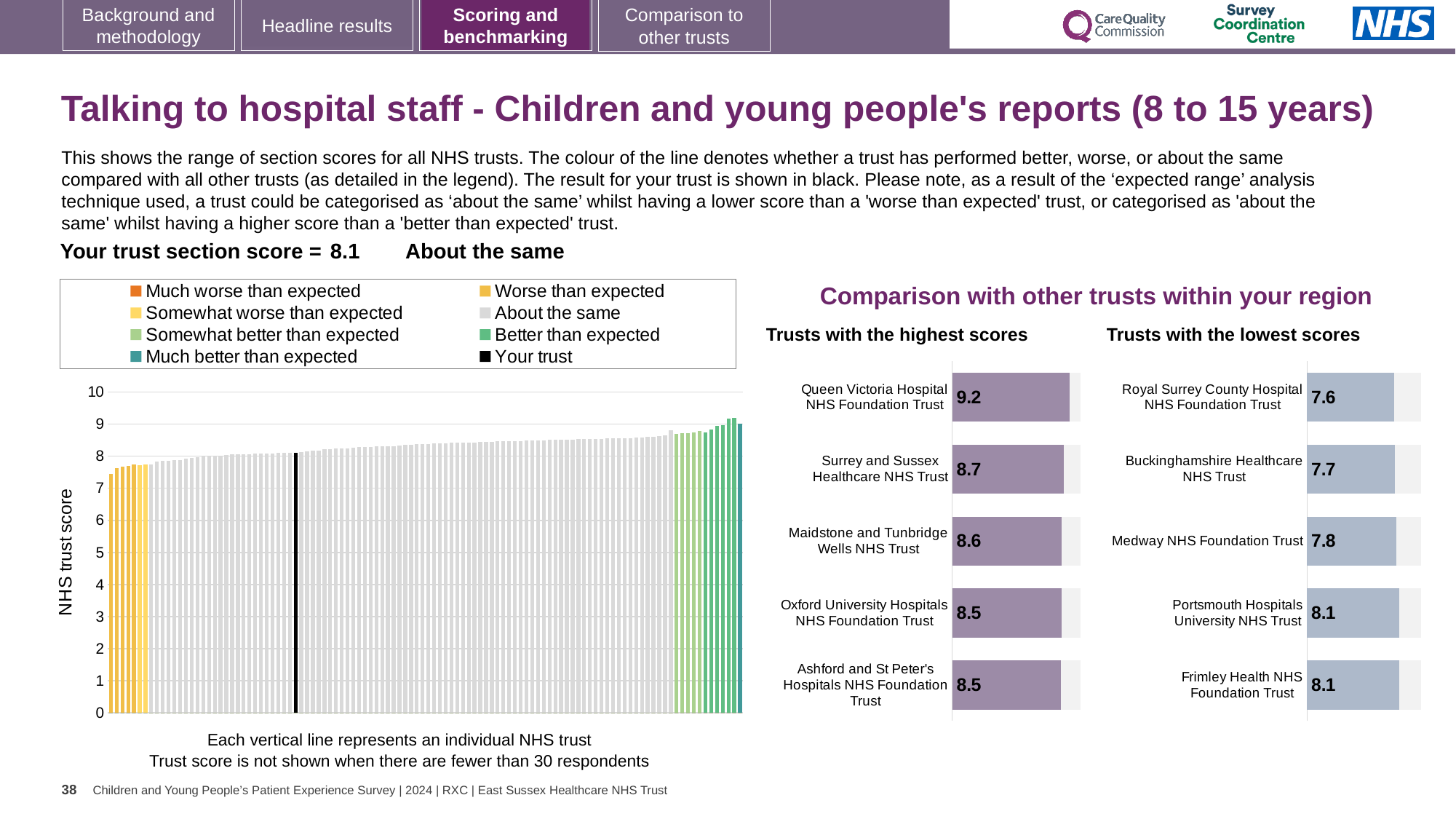
In the 'Trusts with the lowest scores' chart, what is the score for Frimley Health NHS Foundation Trust? 8.1 In the 'Trusts with the highest scores' chart, what is the score for Queen Victoria Hospital NHS Foundation Trust? 9.2 In the 'Trusts with the lowest scores' chart, which trust has the lowest score? Royal Surrey County Hospital NHS Foundation Trust In the 'Trusts with the lowest scores' chart, which has the larger score: Buckinghamshire Healthcare NHS Trust or Portsmouth Hospitals University NHS Trust? Portsmouth Hospitals University NHS Trust How many entries does the legend of the large chart on the left list? 8 What kind of chart is the large chart on the left showing NHS trust scores? Bar chart In the large chart on the left, do the trust scores rise or fall from left to right? Rise In the 'Trusts with the lowest scores' chart, what is the score for Medway NHS Foundation Trust? 7.8 In the 'Trusts with the highest scores' chart, which trust has the highest score? Queen Victoria Hospital NHS Foundation Trust In the 'Trusts with the highest scores' chart, what is the difference between the scores of Queen Victoria Hospital NHS Foundation Trust and Surrey and Sussex Healthcare NHS Trust? 0.5 What is the y-axis label of the large chart on the left? NHS trust score How many trusts are listed in the 'Trusts with the highest scores' chart? 5